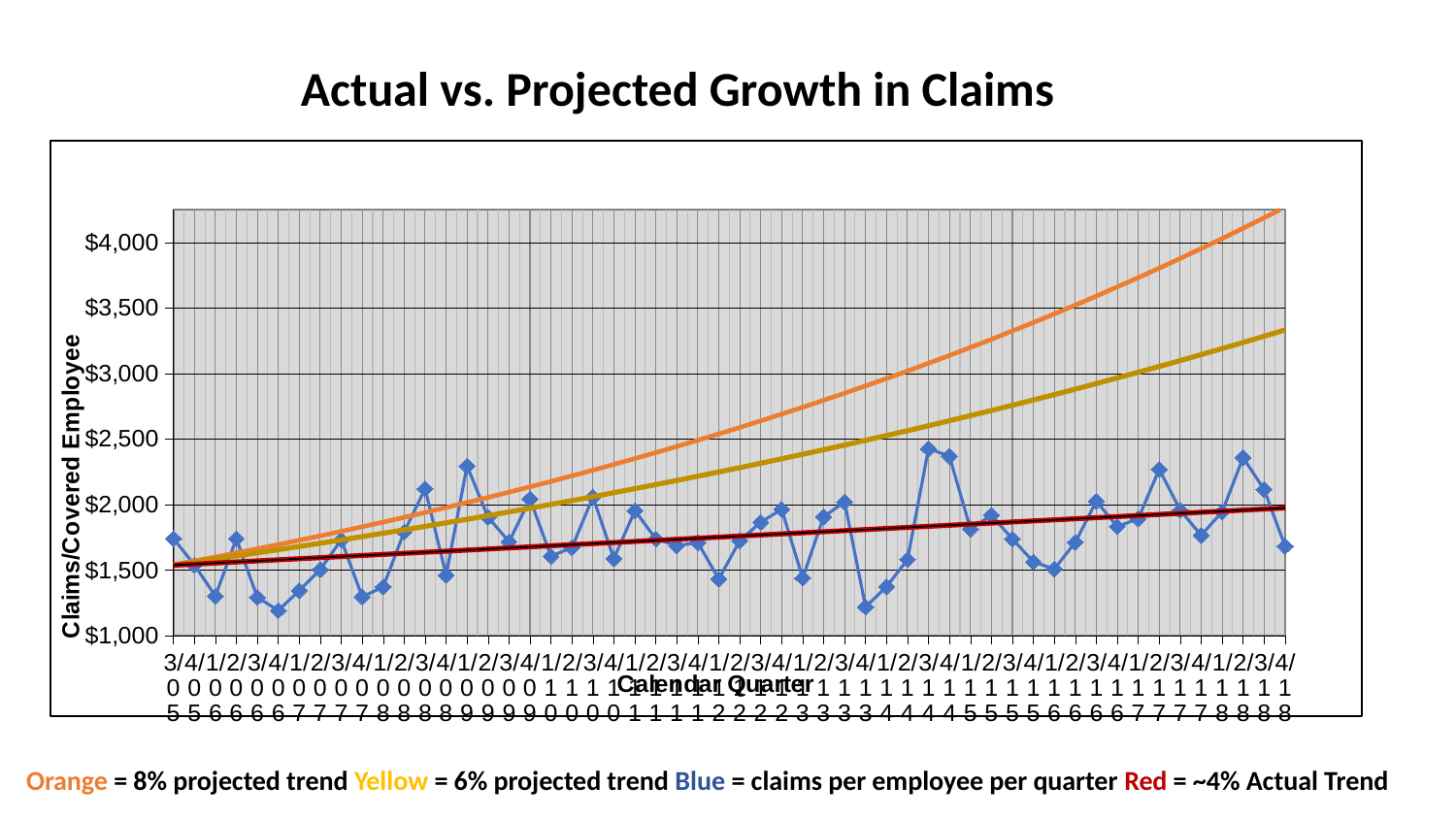
How many series does the legend text below the chart describe? 4 Does the orange 8% projected trend line rise or fall from left to right along the x axis? Rise Is the highest point of the blue claims per employee series greater or less than $2,000? greater Is the lowest point of the blue claims per employee series greater or less than $1,500? less Is the value of the red ~4% actual trend line at the first quarter (3/05) greater or less than $2,000? less Which series reaches the highest value on the chart? Orange 8% projected trend What kind of chart is shown on the slide? Line chart According to the legend text below the chart, what does the orange line represent? 8% projected trend What is the title of the chart? Actual vs. Projected Growth in Claims At the last quarter (4/18), which line is higher: the orange 8% projected trend or the yellow 6% projected trend? Orange 8% projected trend